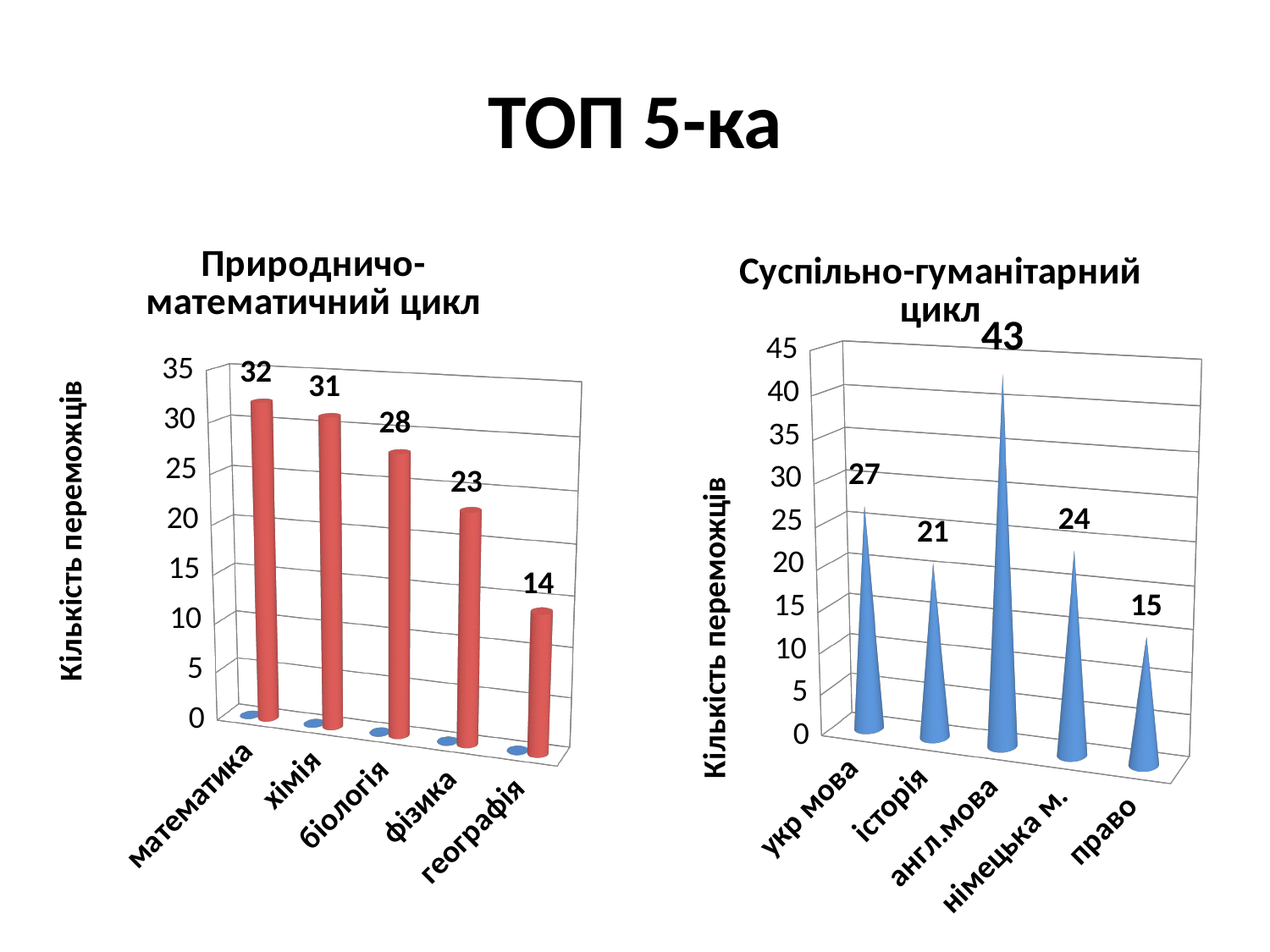
In the 'Природничо-математичний цикл' chart, what is the value for географія? 14 In the 'Природничо-математичний цикл' chart, what is the value for математика? 32 In the 'Суспільно-гуманітарний цикл' chart, what is the value for історія? 21 In the 'Природничо-математичний цикл' chart, how many categories are shown? 5 In the 'Суспільно-гуманітарний цикл' chart, which is larger, укр мова or німецька м.? укр мова What is the y-axis label of the 'Природничо-математичний цикл' chart? Кількість переможців In the 'Суспільно-гуманітарний цикл' chart, what is the difference between англ.мова and право? 28 In the 'Суспільно-гуманітарний цикл' chart, which category has the highest value? англ.мова In the 'Природничо-математичний цикл' chart, which category has the lowest value? географія In the 'Природничо-математичний цикл' chart, what is the difference between хімія and фізика? 8 In the 'Суспільно-гуманітарний цикл' chart, what is the value for англ.мова? 43 In the 'Природничо-математичний цикл' chart, do the values rise or fall from left to right along the x axis? fall